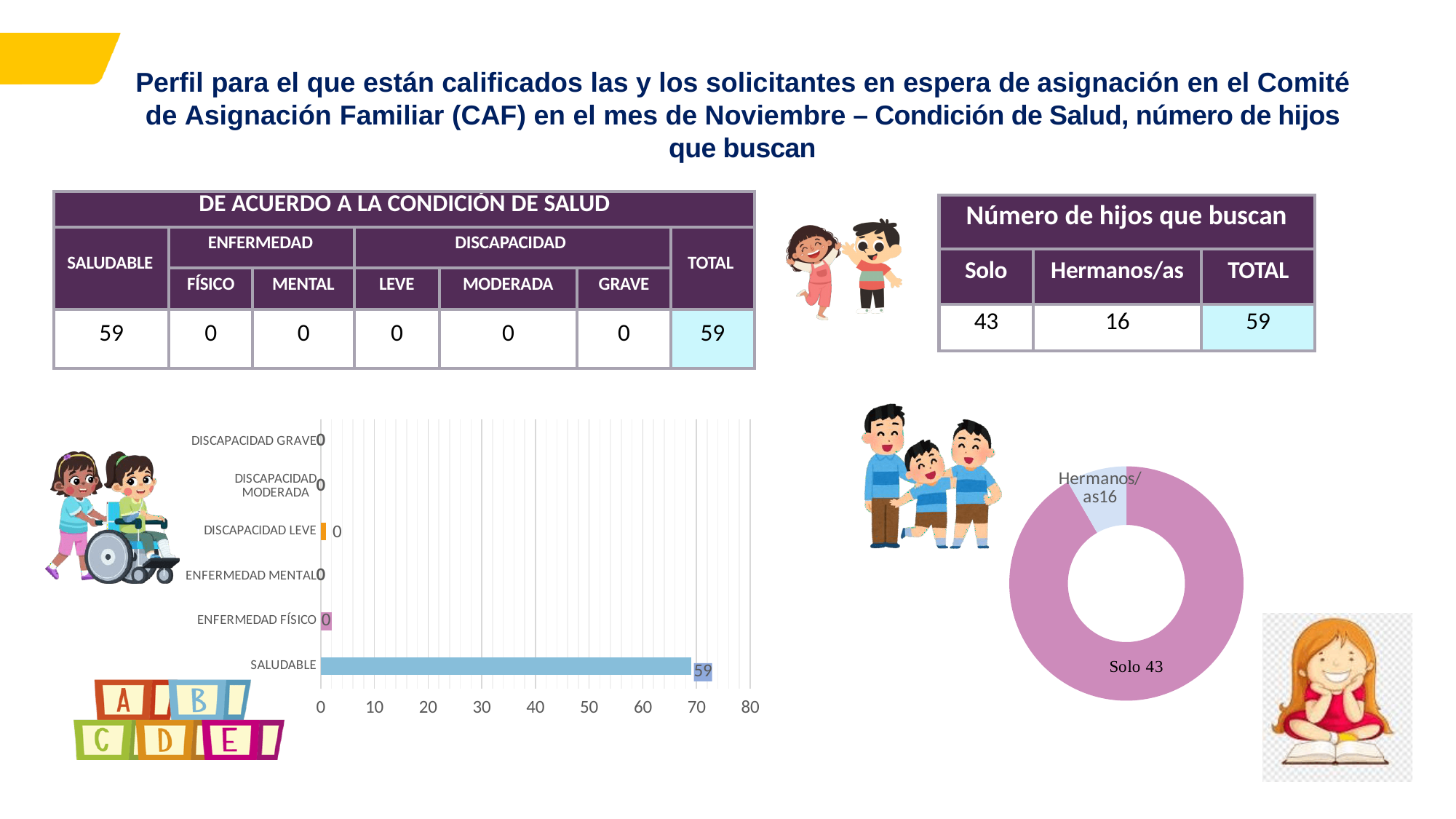
In the doughnut chart on the bottom right, which slice is larger, Solo or Hermanos/as? Solo In the bar chart on the bottom left, what is the value for ENFERMEDAD MENTAL? 0 What kind of chart is the chart on the bottom left of the slide? Bar chart In the doughnut chart on the bottom right, what is the difference between Solo and Hermanos/as? 27 In the doughnut chart on the bottom right, what is the value for Solo? 43 In the bar chart on the bottom left, is the value for SALUDABLE greater or less than 50? greater In the bar chart on the bottom left, which category has the highest value? SALUDABLE What kind of chart is the chart on the bottom right of the slide? Doughnut chart In the bar chart on the bottom left, how many categories are shown? 6 In the bar chart on the bottom left, what is the difference between SALUDABLE and DISCAPACIDAD GRAVE? 59 In the bar chart on the bottom left, what is the value for SALUDABLE? 59 In the doughnut chart on the bottom right, what is the value for Hermanos/as? 16